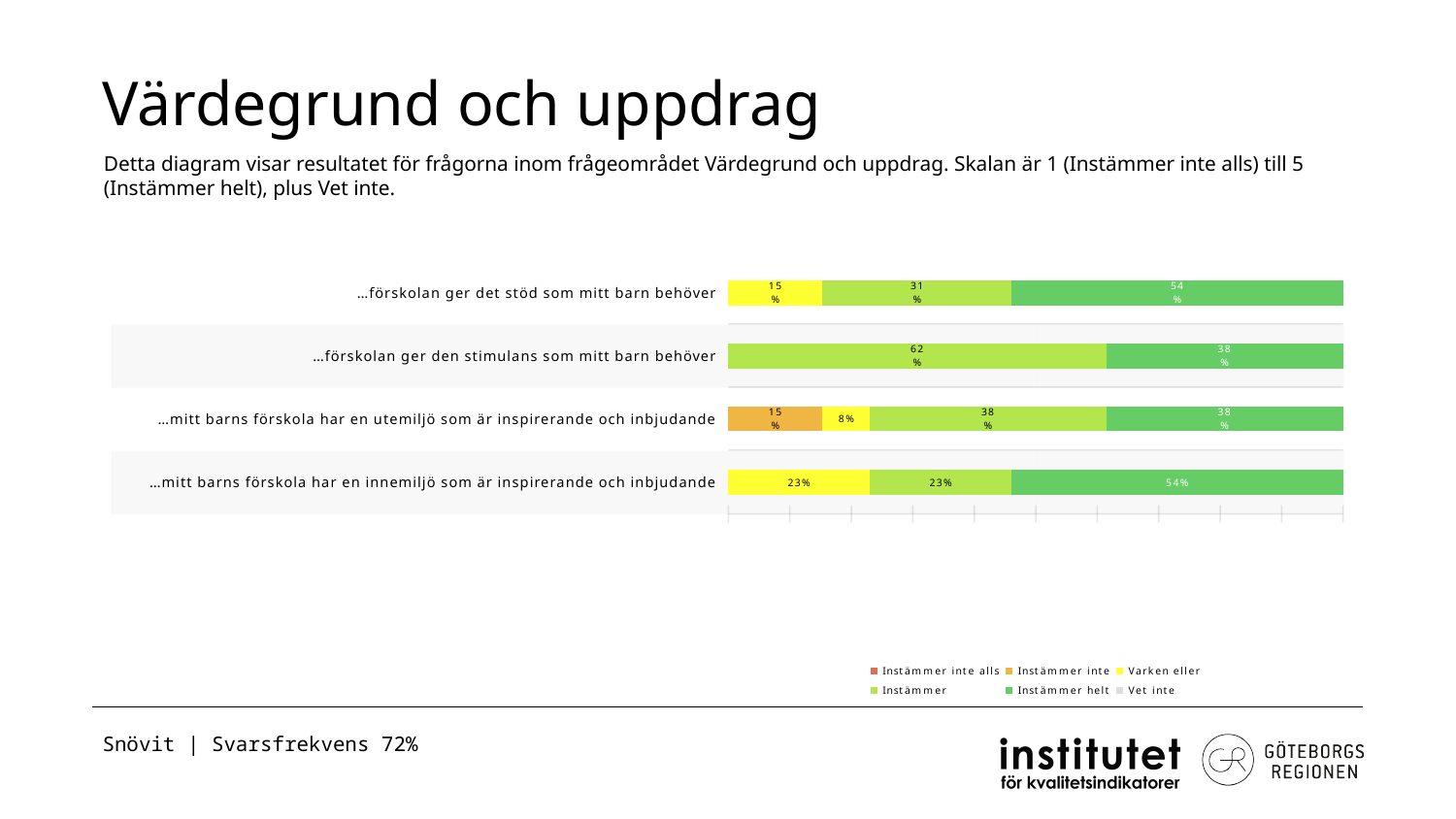
Which category has the highest 'Instämmer' value? …förskolan ger den stimulans som mitt barn behöver What is the 'Instämmer helt' value for '…förskolan ger det stöd som mitt barn behöver'? 54% What is the 'Instämmer' value for '…förskolan ger den stimulans som mitt barn behöver'? 62% For '…mitt barns förskola har en utemiljö som är inspirerande och inbjudande', which is larger: 'Instämmer inte' or 'Varken eller'? Instämmer inte What is the combined total of 'Instämmer' and 'Instämmer helt' for '…förskolan ger det stöd som mitt barn behöver'? 85% What is the 'Varken eller' value for '…mitt barns förskola har en innemiljö som är inspirerande och inbjudande'? 23% How many categories (questions) are plotted in the chart? 4 How many series does the legend list? 6 What is the 'Instämmer inte' value for '…mitt barns förskola har en utemiljö som är inspirerande och inbjudande'? 15% What type of chart is shown on the slide? stacked bar chart What is the difference between the 'Instämmer' and 'Instämmer helt' values for '…förskolan ger den stimulans som mitt barn behöver'? 24%